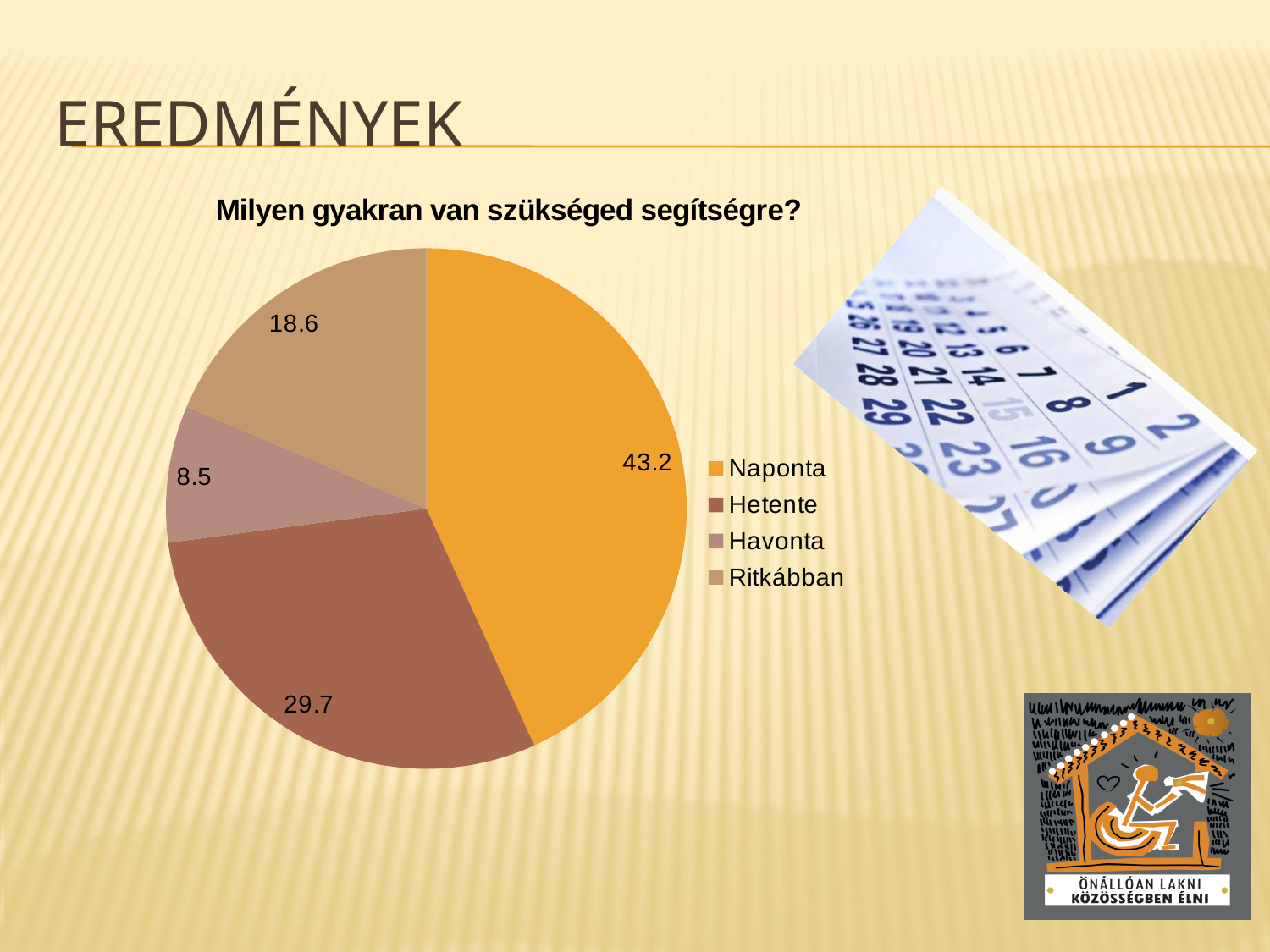
Which is larger, the value for Hetente or the value for Ritkábban? Hetente What is the value for Ritkábban in the pie chart? 18.6 What is the difference between the values for Ritkábban and Havonta? 10.1 How many categories does the pie chart show? 4 Which category has the smallest slice of the pie chart? Havonta What is the value for Havonta in the pie chart? 8.5 What is the value for Naponta in the pie chart? 43.2 Which category has the largest slice of the pie chart? Naponta What is the title of the chart? Milyen gyakran van szükséged segítségre? What is the value for Hetente in the pie chart? 29.7 What kind of chart is shown on the slide? Pie chart What is the difference between the values for Naponta and Hetente? 13.5